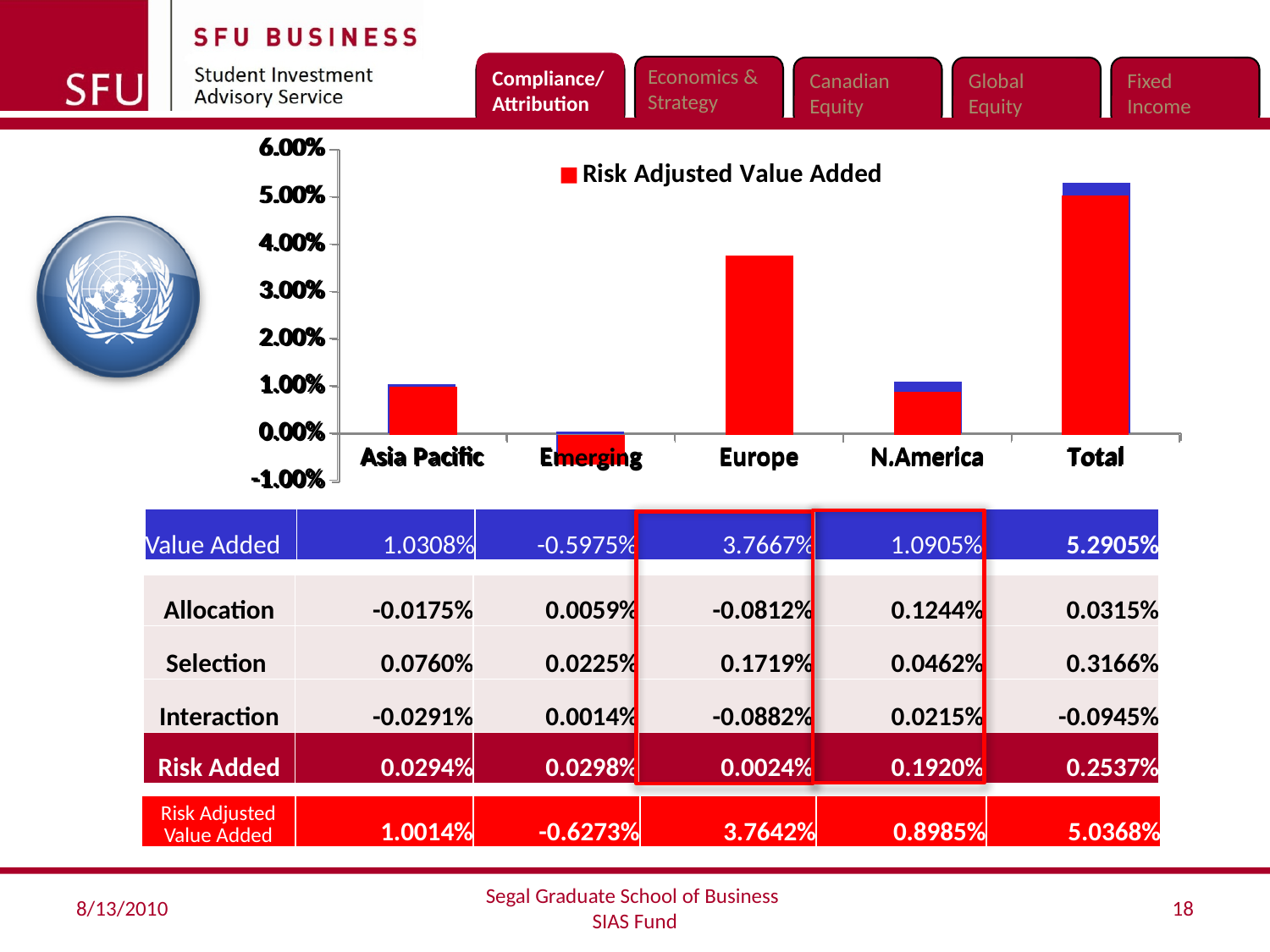
What kind of chart is shown on the slide? bar chart Which has the larger Risk Adjusted Value Added bar, Europe or N.America? Europe Is the Risk Adjusted Value Added bar for Europe greater or less than 3.00%? greater How many series does the chart legend list? 1 Which category has the lowest Risk Adjusted Value Added bar? Emerging What is the name of the series shown in the chart legend? Risk Adjusted Value Added Using the Risk Adjusted Value Added figures in the table, what is the difference between Total and Europe? 1.2726% What colour are the Risk Adjusted Value Added bars in the chart? red According to the table below the chart, what is the Risk Adjusted Value Added for Europe? 3.7642% Which category has the highest Risk Adjusted Value Added bar? Total How many categories are shown on the x axis of the chart? 5 Is the Risk Adjusted Value Added bar for Emerging greater or less than 0.00%? less